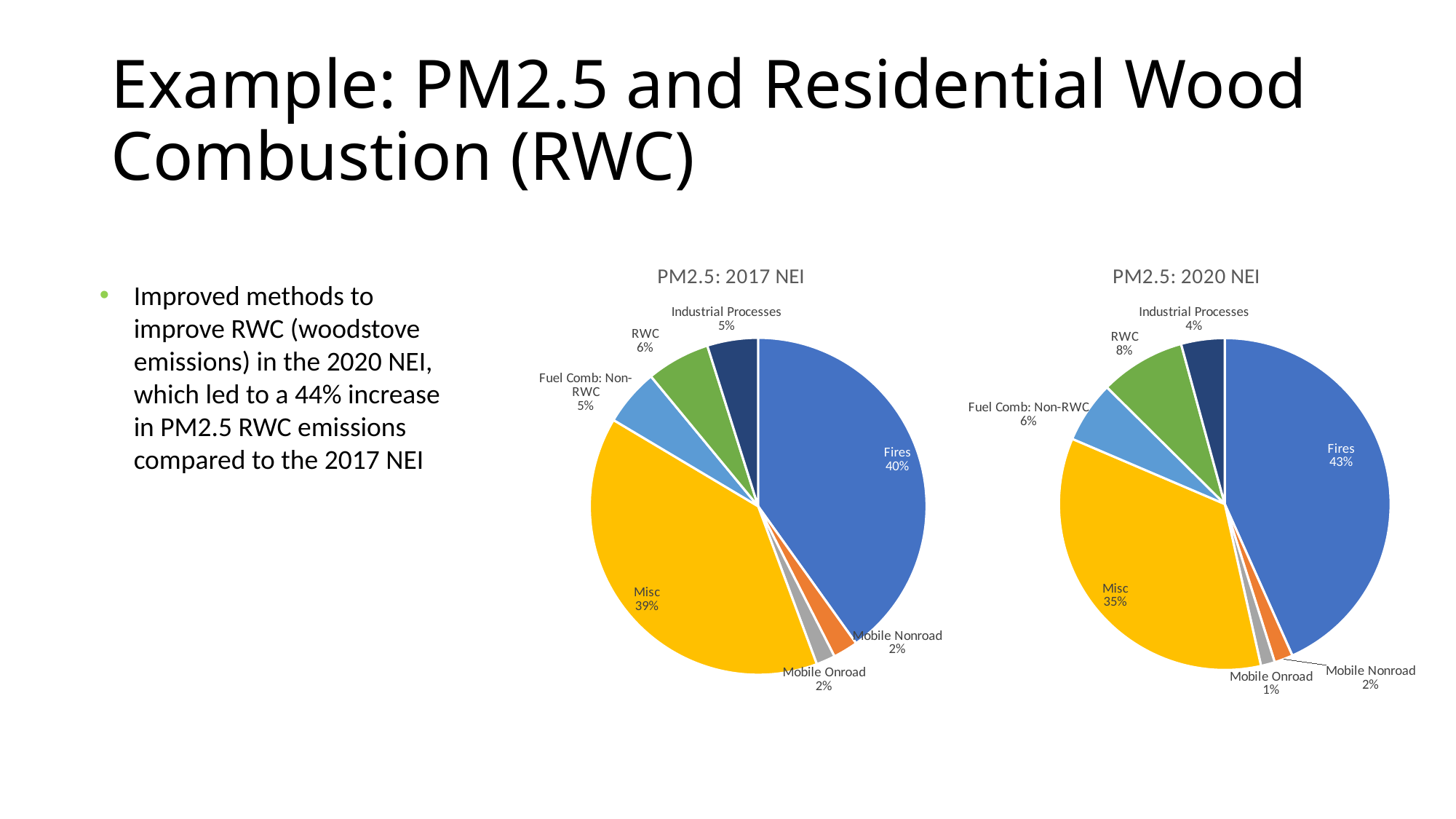
In the 'PM2.5: 2020 NEI' chart, what share does RWC have? 8% What type of chart is 'PM2.5: 2017 NEI'? Pie chart In the 'PM2.5: 2017 NEI' chart, which is larger, the share for RWC or the share for Fuel Comb: Non-RWC? RWC In the 'PM2.5: 2017 NEI' chart, what is the value for Misc? 39% In the 'PM2.5: 2017 NEI' chart, which category has the largest share? Fires In the 'PM2.5: 2020 NEI' chart, which category has the smallest share? Mobile Onroad What is the difference between the RWC share in the 'PM2.5: 2020 NEI' chart and the RWC share in the 'PM2.5: 2017 NEI' chart? 2% In the 'PM2.5: 2017 NEI' chart, what share does Fires have? 40% What is the title of the chart on the right side of the slide? PM2.5: 2020 NEI In the 'PM2.5: 2020 NEI' chart, what is the value for Industrial Processes? 4% How many categories are shown in the 'PM2.5: 2020 NEI' chart? 7 In the 'PM2.5: 2020 NEI' chart, which category has the largest share? Fires